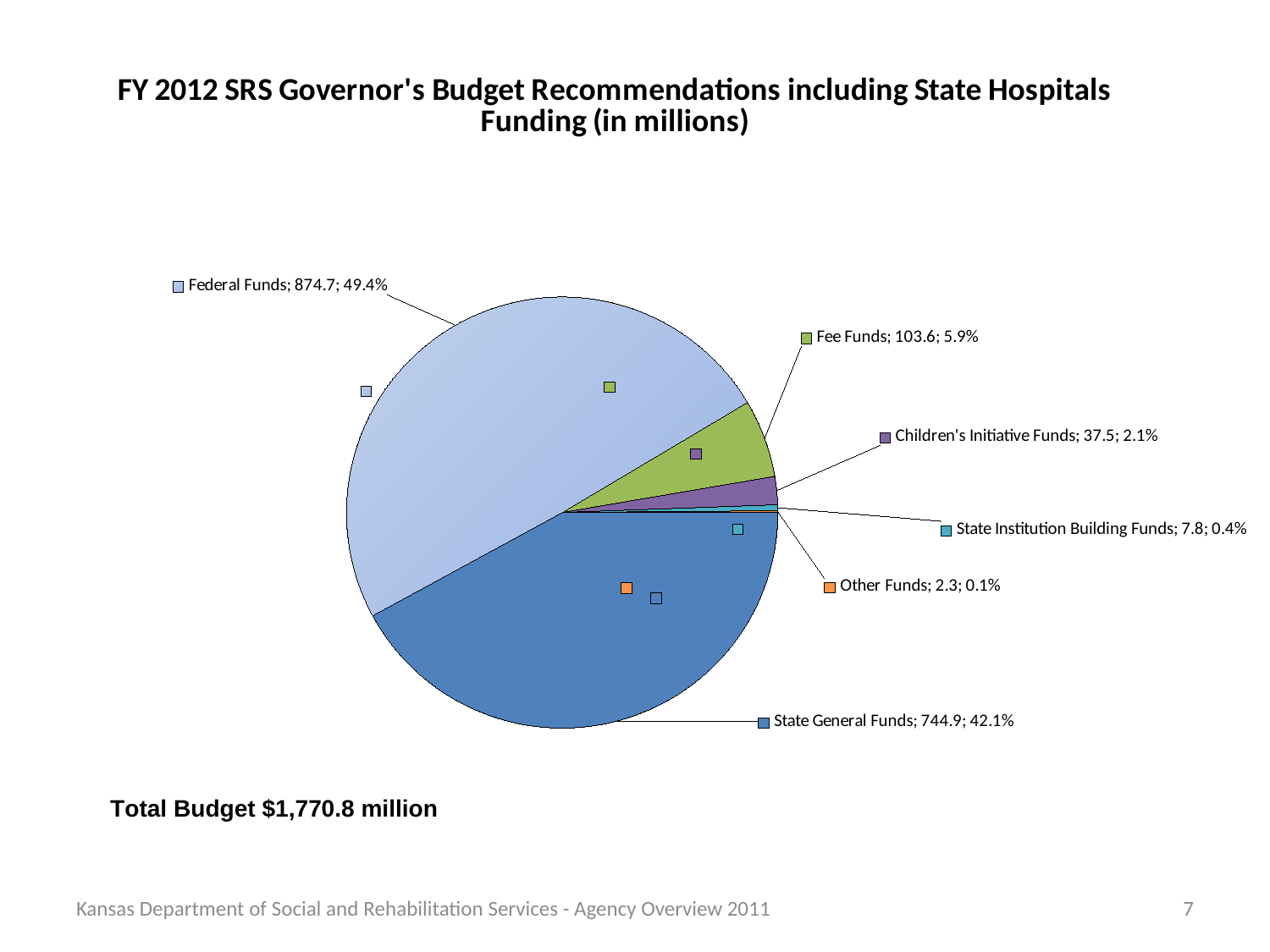
Which category has the largest slice of the pie? Federal Funds What share of the pie is State Institution Building Funds? 0.4% What is the value for State General Funds? 744.9 What is the value for Children's Initiative Funds? 37.5 What kind of chart is shown on the slide? Pie chart What is the difference between the values for Federal Funds and State General Funds? 129.8 What is the value for Fee Funds? 103.6 Which is larger, Fee Funds or Children's Initiative Funds? Fee Funds How many categories are shown in the pie chart? 6 What is the value for Federal Funds? 874.7 Which category has the smallest slice of the pie? Other Funds What share of the pie is Other Funds? 0.1%